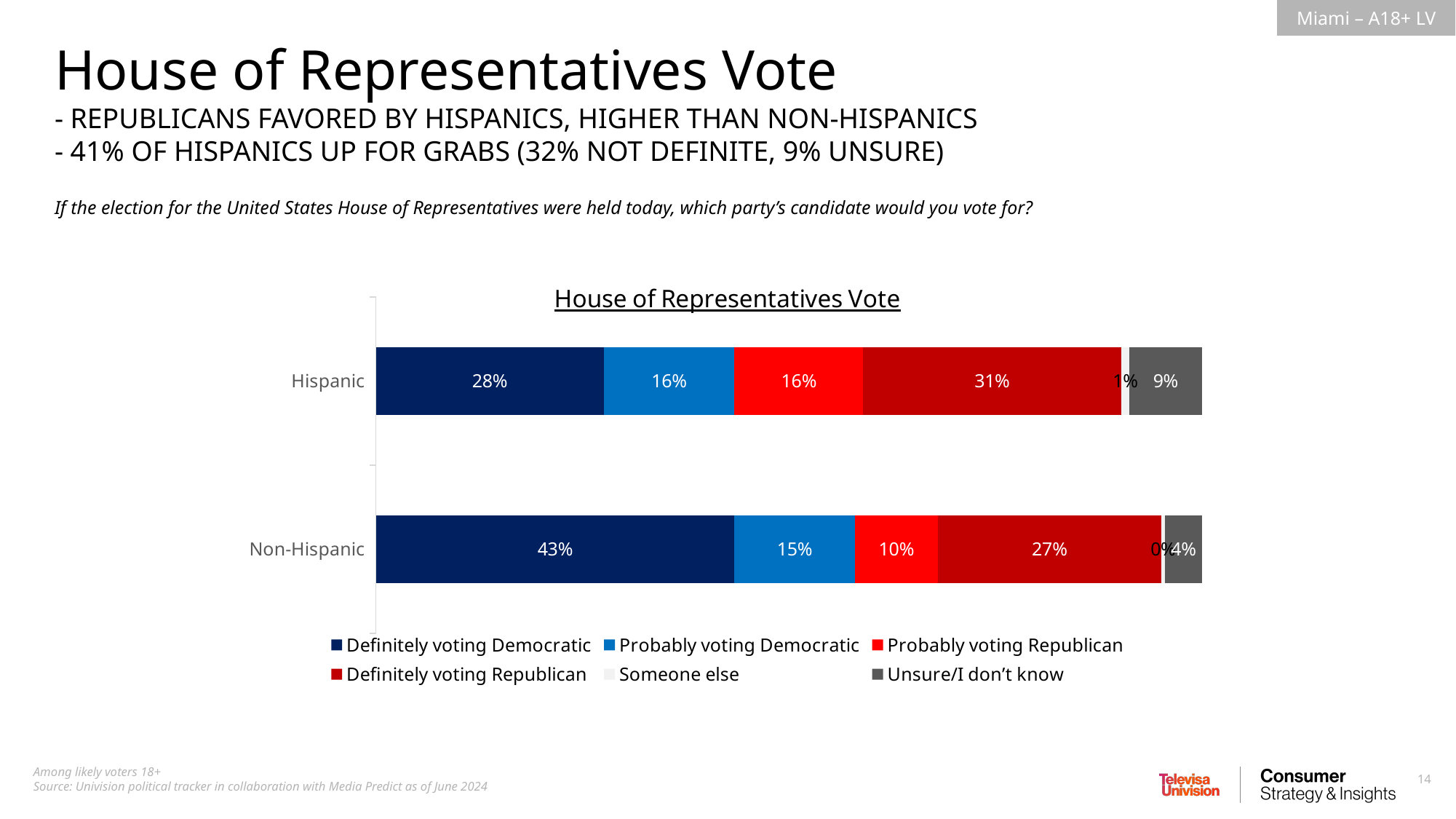
What percentage of Hispanic likely voters are definitely voting Democratic? 28% What percentage of Hispanic likely voters are probably voting Republican? 16% What percentage of Non-Hispanic likely voters are definitely voting Democratic? 43% What kind of chart is shown on the slide? Stacked bar chart How many series does the legend list? 6 What percentage of Hispanic likely voters are definitely voting Republican? 31% What is the title of the chart? House of Representatives Vote How many categories (groups) are shown on the chart? 2 Which group has the larger share unsure/don't know, Hispanic or Non-Hispanic? Hispanic What is the difference between the Non-Hispanic and Hispanic shares definitely voting Democratic? 15 percentage points Which group has the larger share definitely voting Republican, Hispanic or Non-Hispanic? Hispanic What percentage of Non-Hispanic likely voters are unsure/don't know? 4%